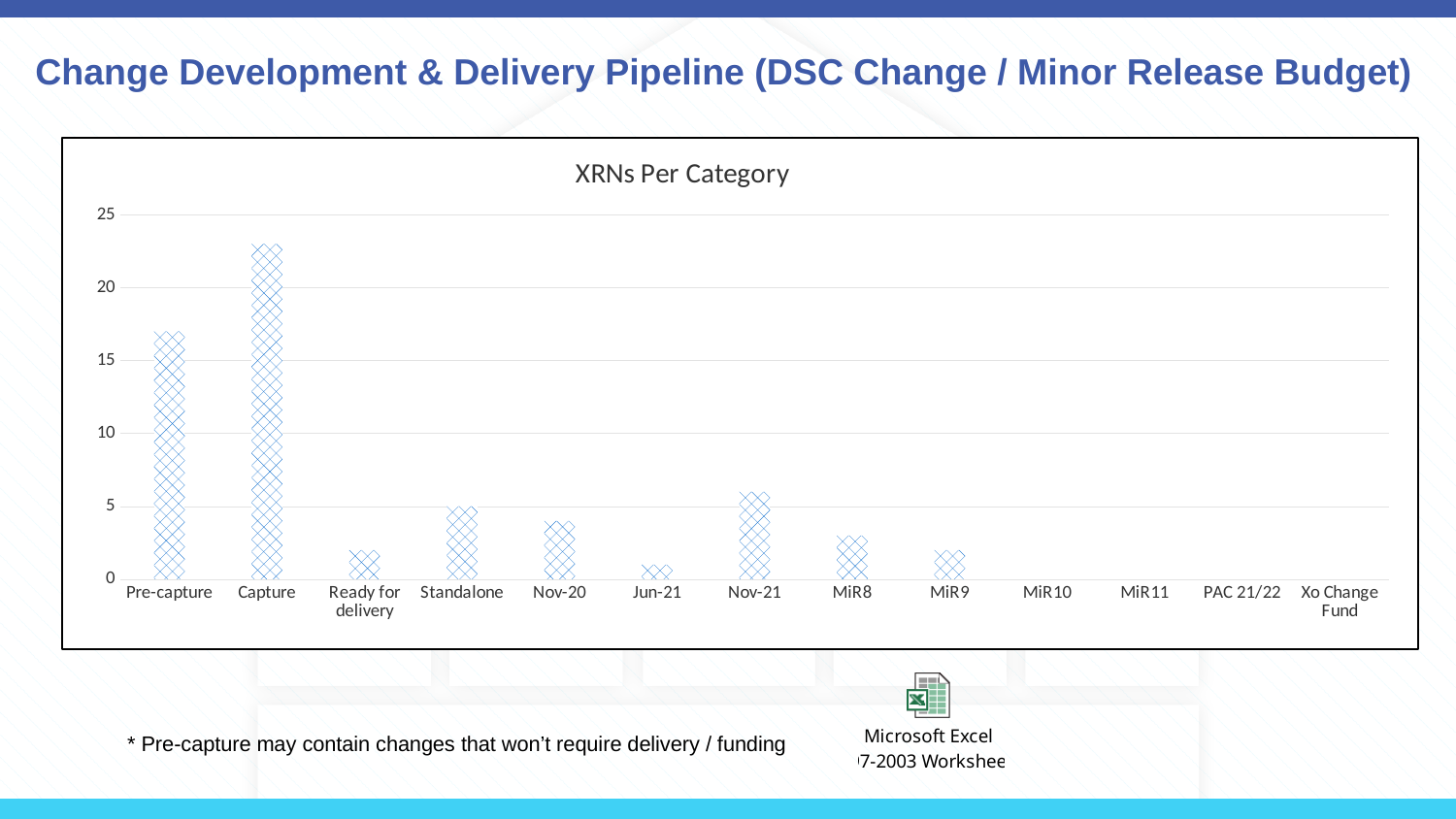
What kind of chart is shown on the slide? bar chart Is the value for Pre-capture greater or less than 20? less Which category has the highest value in the chart? Capture What is the title of the chart? XRNs Per Category Is the value for MiR8 greater or less than 5? less Which is larger, the value for Nov-20 or the value for Nov-21? Nov-21 How many categories are shown on the x axis of the chart? 13 Is the value for Ready for delivery greater or less than 5? less What is the highest value shown on the y axis of the chart? 25 Which is larger, the value for Pre-capture or the value for Capture? Capture